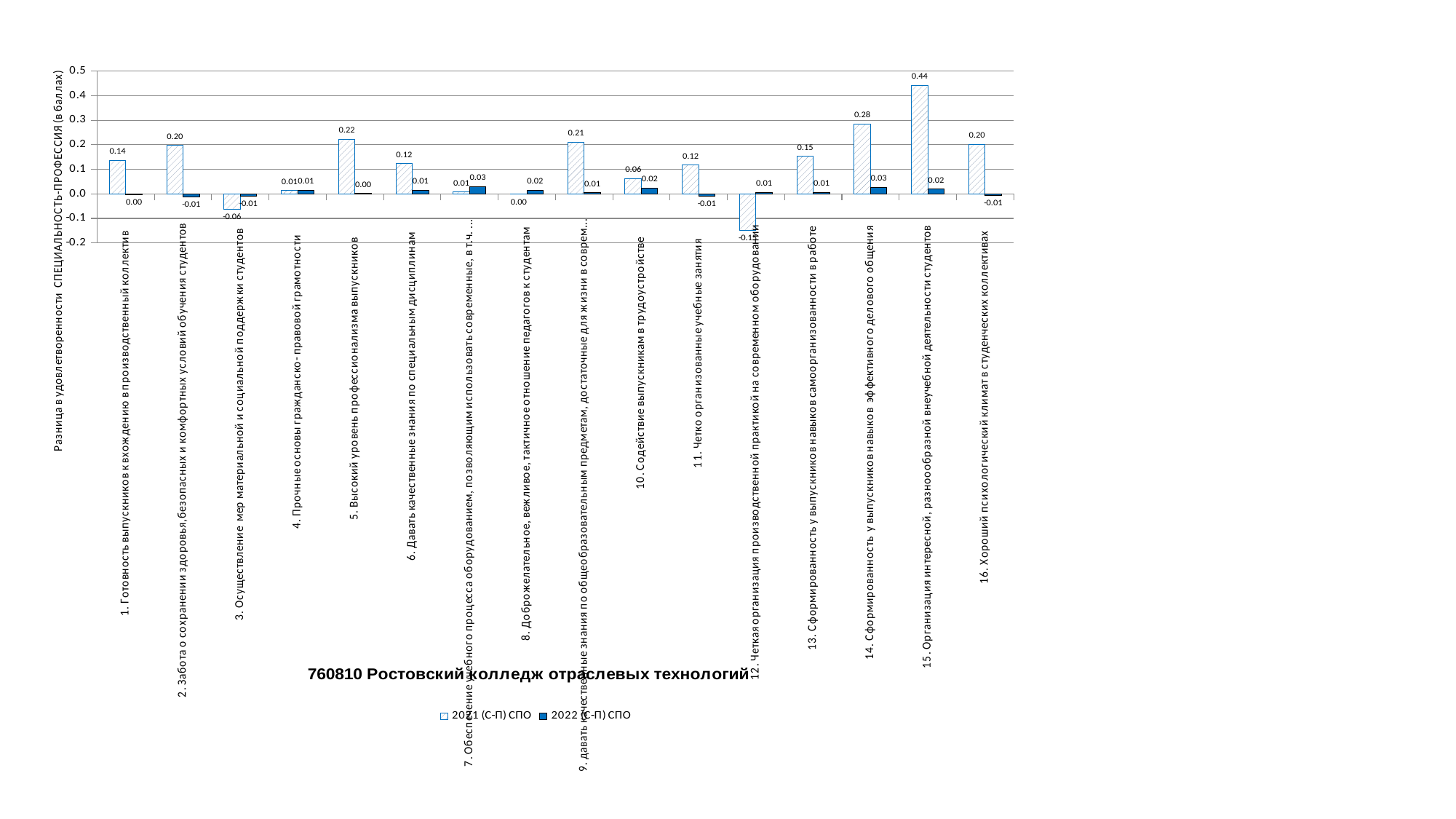
Which category has the highest 2021 (С-П) СПО value? 15. Организация интересной, разнообразной внеучебной деятельности студентов What is the 2022 (С-П) СПО value for category 14, 'Сформированность у выпускников навыков эффективного делового общения'? 0.03 How many series does the legend list? 2 Is the 2021 (С-П) СПО value for category 15 greater or less than 0.4? greater What is the 2021 (С-П) СПО value for category 15, 'Организация интересной, разнообразной внеучебной деятельности студентов'? 0.44 What is the difference between the 2021 (С-П) СПО values for category 14 (0.28) and category 5 (0.22)? 0.06 For category 7, 'Обеспечение учебного процесса оборудованием...', which series has the larger value, 2021 (С-П) СПО or 2022 (С-П) СПО? 2022 (С-П) СПО How many categories are shown on the x axis? 16 What is the 2021 (С-П) СПО value for category 3, 'Осуществление мер материальной и социальной поддержки студентов'? -0.06 What is the title of the chart? 760810 Ростовский колледж отраслевых технологий Which category has the lowest 2021 (С-П) СПО value? 12. Четкая организация производственной практикой на современном оборудовании What type of chart is shown on the slide? bar chart